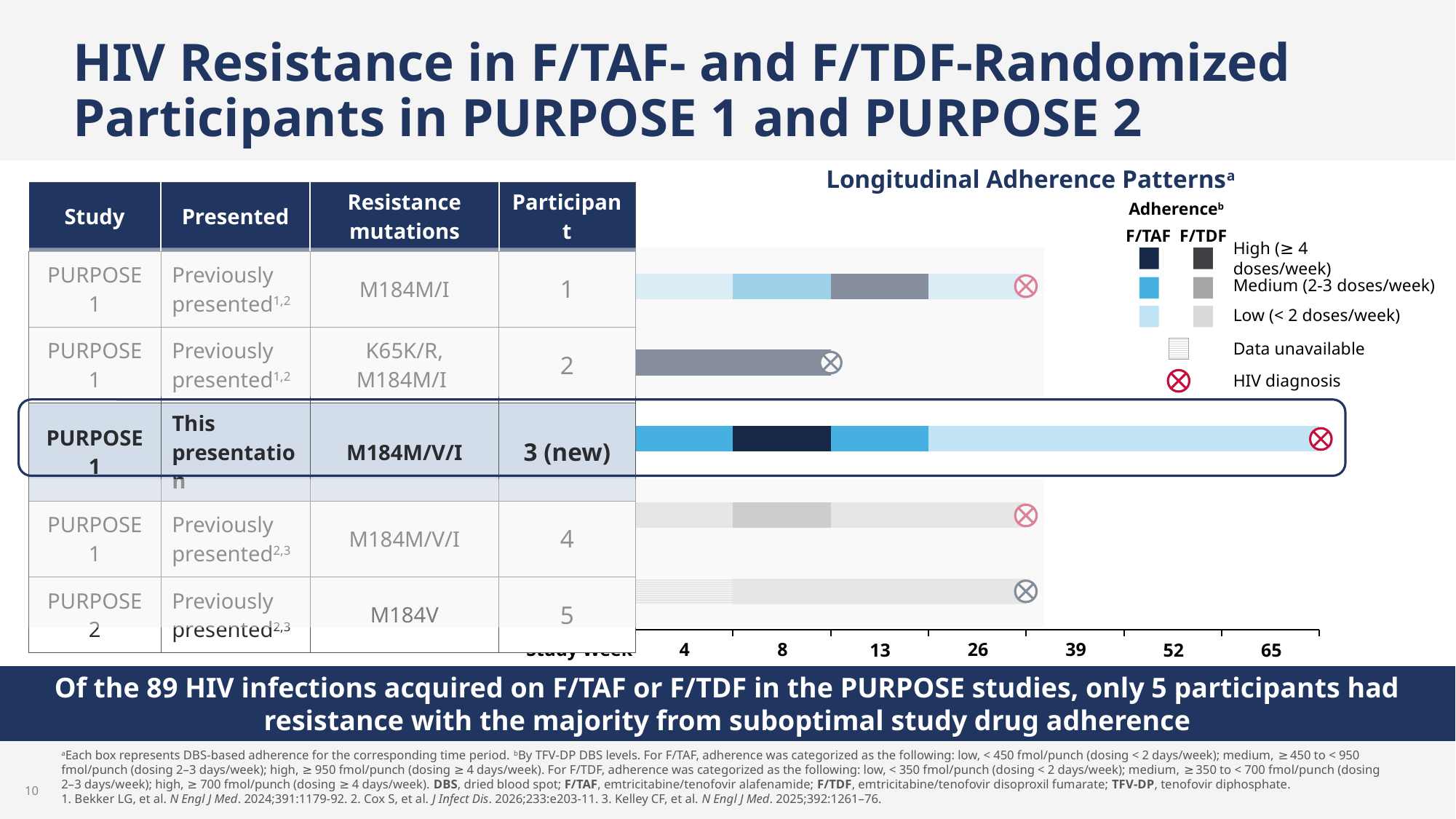
In the Longitudinal Adherence Patterns chart, which participant's HIV diagnosis occurs later along the study week axis, participant 2 or participant 5? Participant 5 In the Longitudinal Adherence Patterns chart, is the study week of participant 2's HIV diagnosis greater or less than 13? less In the Longitudinal Adherence Patterns chart, what does the circled X symbol in the legend represent? HIV diagnosis In the Longitudinal Adherence Patterns chart, which participant has the HIV diagnosis marker furthest to the right along the study week axis? Participant 3 (new) In the Longitudinal Adherence Patterns chart, how many study week tick labels are shown on the x axis? 7 In the Longitudinal Adherence Patterns chart, which participant's row includes a High (≥ 4 doses/week) adherence box? Participant 3 (new) In the Longitudinal Adherence Patterns chart, which participant's row includes a Data unavailable box? Participant 5 In the Longitudinal Adherence Patterns chart, how many participant rows are plotted? 5 In the Longitudinal Adherence Patterns chart, is the study week of participant 1's HIV diagnosis greater or less than 26? greater In the Longitudinal Adherence Patterns chart, is the study week of participant 3's HIV diagnosis greater or less than 52? greater What is the title of the chart on the right side of the slide? Longitudinal Adherence Patterns In the Longitudinal Adherence Patterns chart, which participant has the earliest HIV diagnosis marker along the study week axis? Participant 2